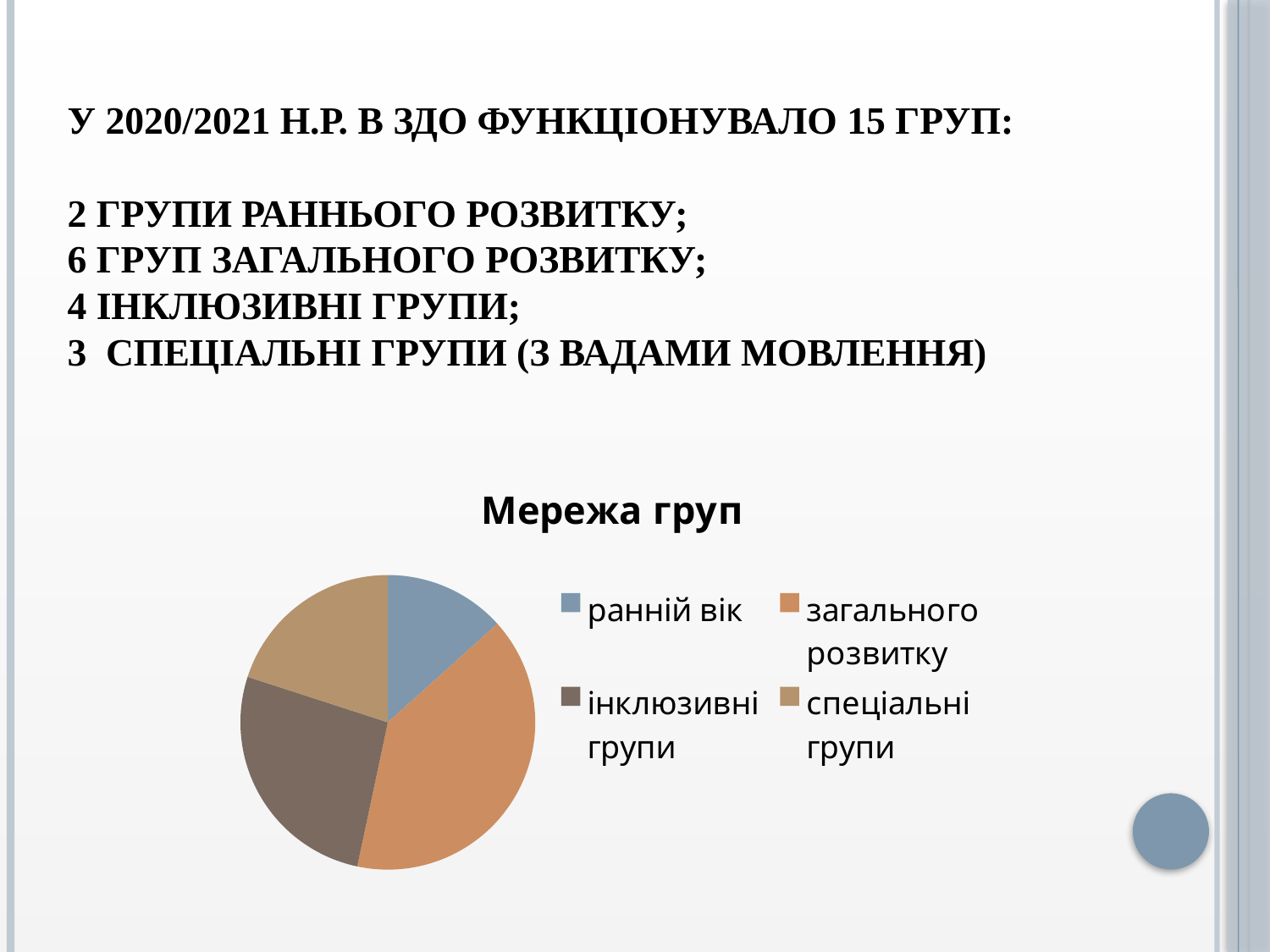
Which slice is larger: інклюзивні групи or ранній вік? інклюзивні групи How many entries does the chart legend list? 4 How many slices does the pie chart have? 4 Which legend entry is shown in orange? загального розвитку Which slice is larger: загального розвитку or ранній вік? загального розвитку Which category has the smallest slice of the pie? ранній вік What kind of chart is shown on the slide? pie chart Which slice is larger: інклюзивні групи or спеціальні групи? інклюзивні групи Which category has the largest slice of the pie? загального розвитку What is the title of the chart? Мережа груп